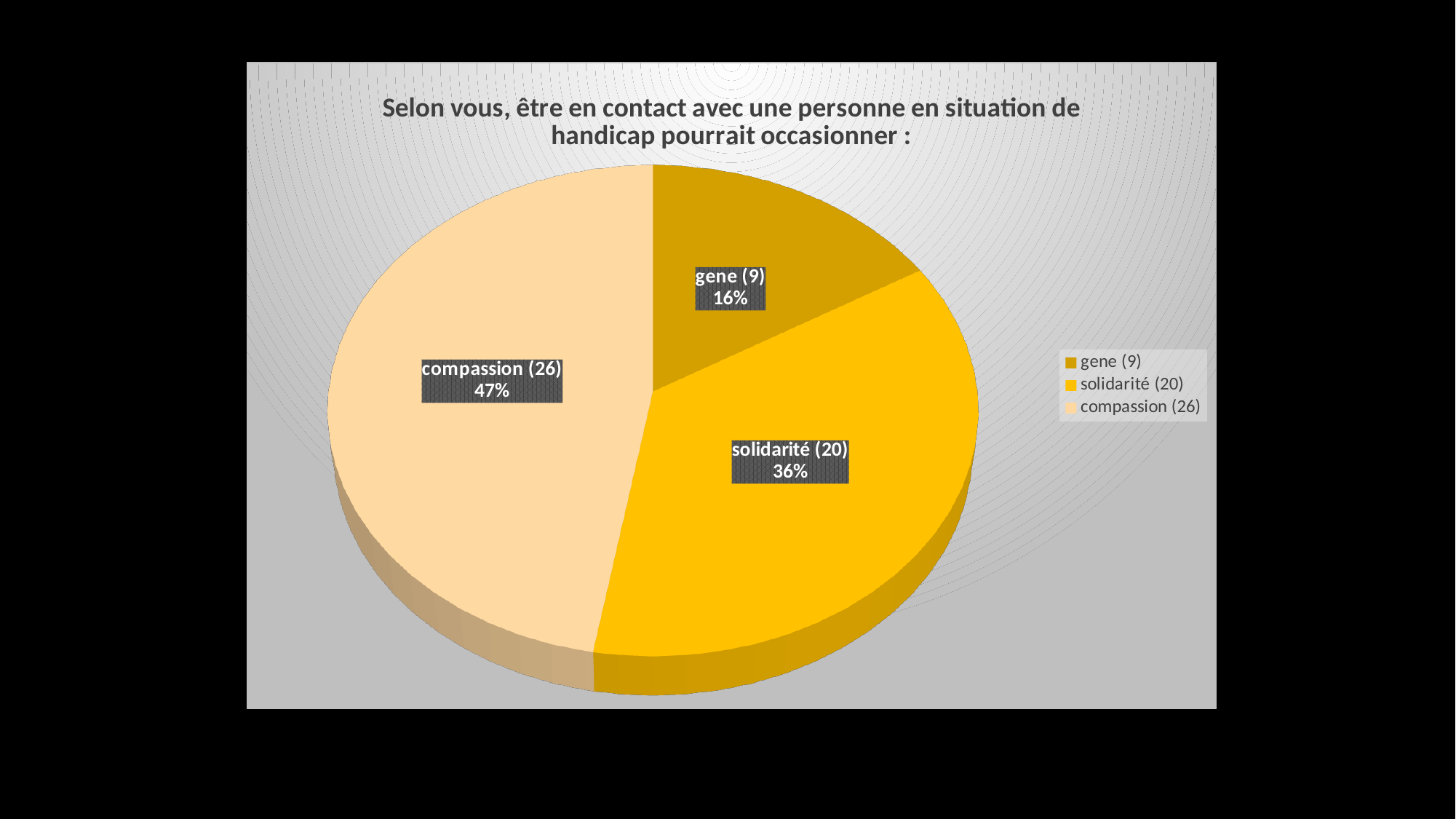
What percentage share does the 'compassion (26)' slice have? 47% What kind of chart is shown on the slide? pie chart How many slices does the pie chart have? 3 What is the title of the chart? Selon vous, être en contact avec une personne en situation de handicap pourrait occasionner : What is the difference in percentage points between the 'solidarité (20)' and 'gene (9)' slices? 20% Which category has the smallest slice of the pie? gene (9) Which slice is larger, 'solidarité (20)' or 'gene (9)'? solidarité (20) What percentage share does the 'solidarité (20)' slice have? 36% What is the difference in percentage points between the 'compassion (26)' and 'solidarité (20)' slices? 11% What percentage share does the 'gene (9)' slice have? 16% Which category has the largest slice of the pie? compassion (26) How many entries does the legend list? 3